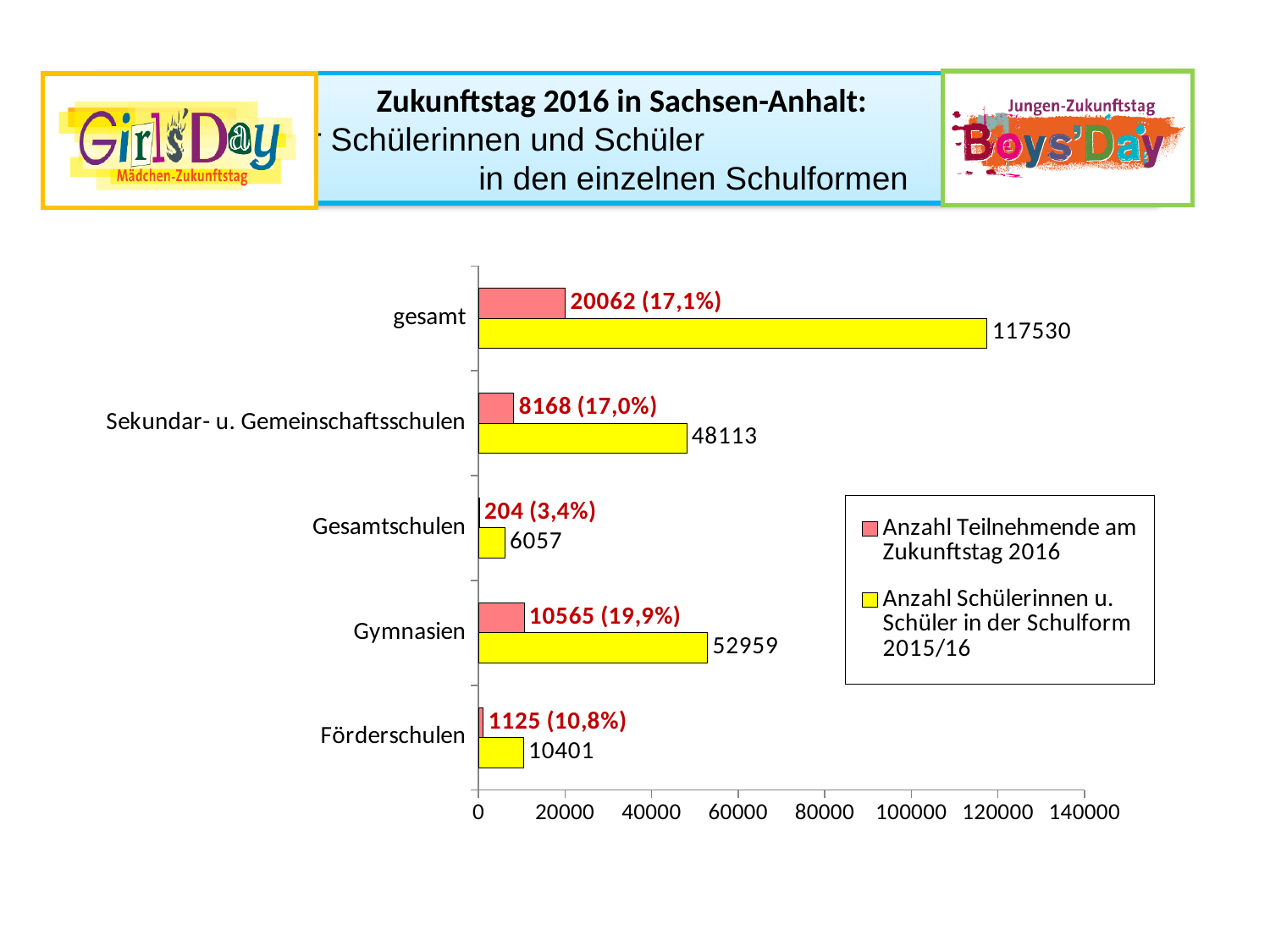
Which is larger in the series "Anzahl Teilnehmende am Zukunftstag 2016": Gymnasien or Sekundar- u. Gemeinschaftsschulen? Gymnasien How many series does the legend list? 2 What is the value for Gymnasien in the series "Anzahl Schülerinnen u. Schüler in der Schulform 2015/16"? 52959 What is the difference between the "Anzahl Schülerinnen u. Schüler in der Schulform 2015/16" values for Gymnasien and Sekundar- u. Gemeinschaftsschulen? 4846 Which school type has the lowest value in the series "Anzahl Teilnehmende am Zukunftstag 2016"? Gesamtschulen What is the data label shown for Förderschulen in the series "Anzahl Teilnehmende am Zukunftstag 2016"? 1125 (10,8%) What is the value for Sekundar- u. Gemeinschaftsschulen in the series "Anzahl Schülerinnen u. Schüler in der Schulform 2015/16"? 48113 Is the "Anzahl Schülerinnen u. Schüler in der Schulform 2015/16" value for gesamt greater or less than 100000? greater What percentage is shown in the data label for Gesamtschulen in the series "Anzahl Teilnehmende am Zukunftstag 2016"? 3,4% What kind of chart is shown on the slide? Bar chart How many categories are shown on the vertical axis of the chart? 5 Excluding the "gesamt" row, which school type has the highest value in the series "Anzahl Schülerinnen u. Schüler in der Schulform 2015/16"? Gymnasien